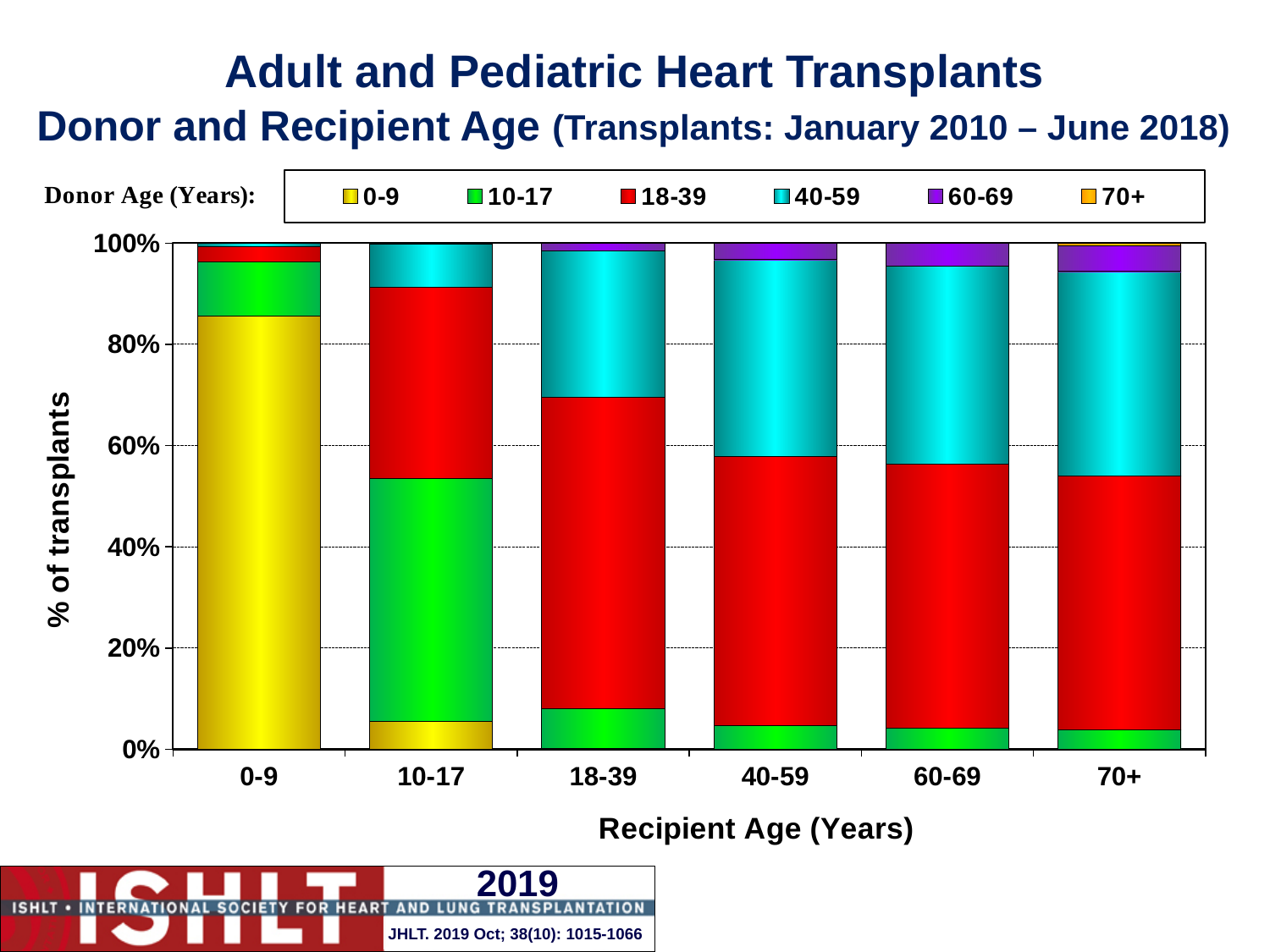
What is the label of the x axis? Recipient Age (Years) What is the total of the stacked bar for recipient age 40-59? 100% Which recipient age group has the largest share of donors aged 18-39? 18-39 How many recipient age groups are shown on the x axis? 6 Is the share of donors aged 0-9 for recipients aged 0-9 greater or less than 80%? greater What kind of chart is shown on the slide? Stacked bar chart What is the label of the y axis? % of transplants Is the share of donors aged 10-17 for recipients aged 10-17 greater or less than 40%? greater How many donor age groups does the legend list? 6 Which recipient age group has the largest share of donors aged 0-9? 0-9 Is the share of donors aged 40-59 for recipients aged 0-9 greater or less than 20%? less Which is larger: the share of donors aged 10-17 for recipients aged 10-17 or for recipients aged 70+? 10-17